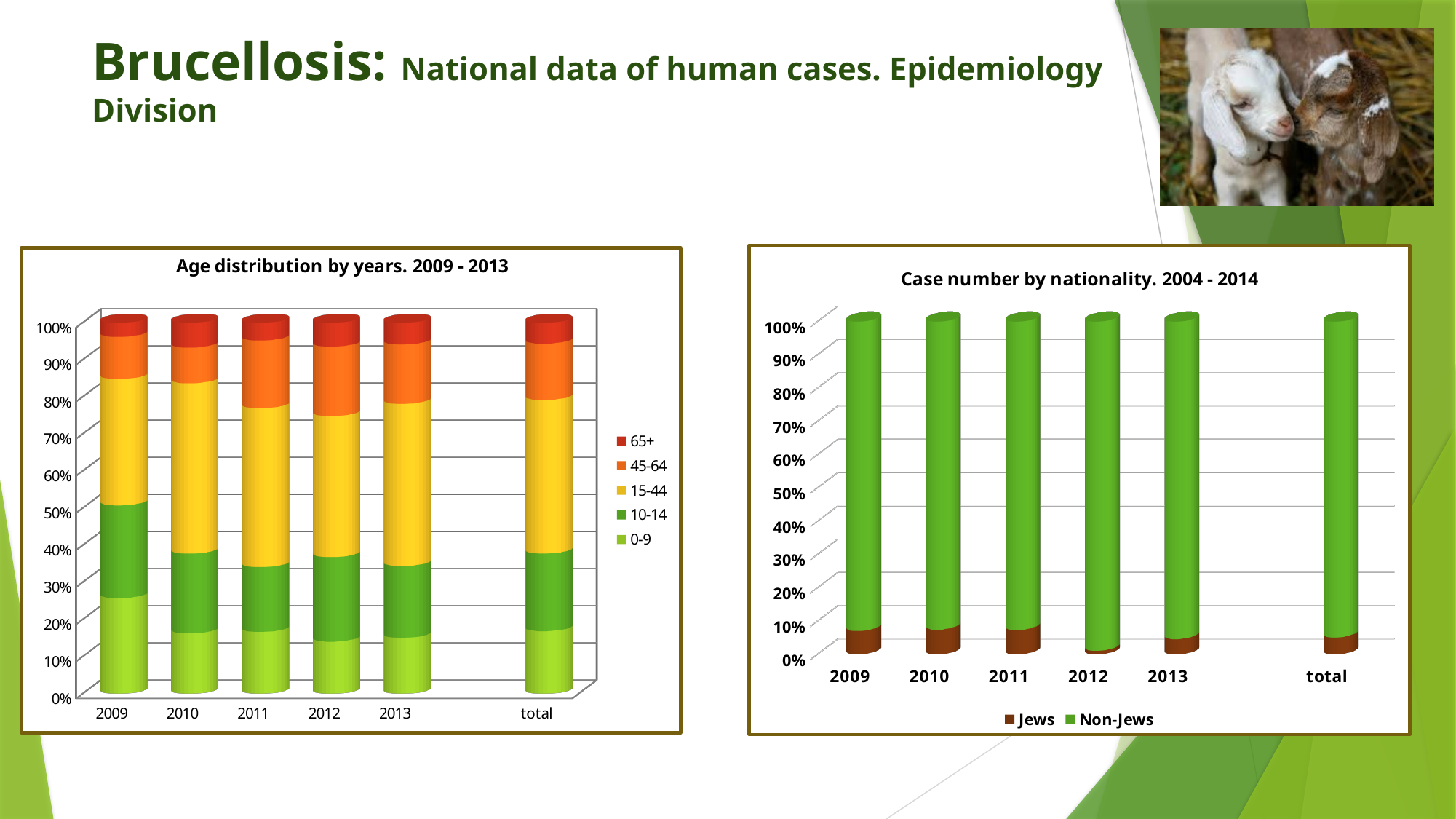
In the 'Case number by nationality. 2004 - 2014' chart, which year has the smallest share for Jews? 2012 How many series does the legend of the 'Age distribution by years. 2009 - 2013' chart list? 5 In the 'Case number by nationality. 2004 - 2014' chart, is the Non-Jews share for 2009 greater or less than 80%? greater What kind of chart is the 'Age distribution by years. 2009 - 2013' chart? Stacked bar chart How many bars are shown in the 'Case number by nationality. 2004 - 2014' chart? 6 In the 'Age distribution by years. 2009 - 2013' chart, which age group is shown in red? 65+ In the 'Age distribution by years. 2009 - 2013' chart, which year has the largest share for the 0-9 age group? 2009 In the 'Age distribution by years. 2009 - 2013' chart, is the 0-9 share for 2009 greater or less than 10%? greater In the 'Case number by nationality. 2004 - 2014' chart, is the Jews share for 2009 larger or smaller than the Jews share for 2012? larger How many series does the legend of the 'Case number by nationality. 2004 - 2014' chart list? 2 How many categories are shown on the x axis of the 'Age distribution by years. 2009 - 2013' chart? 6 In the 'Age distribution by years. 2009 - 2013' chart, is the 0-9 share for 2009 larger or smaller than the 0-9 share for 2010? larger